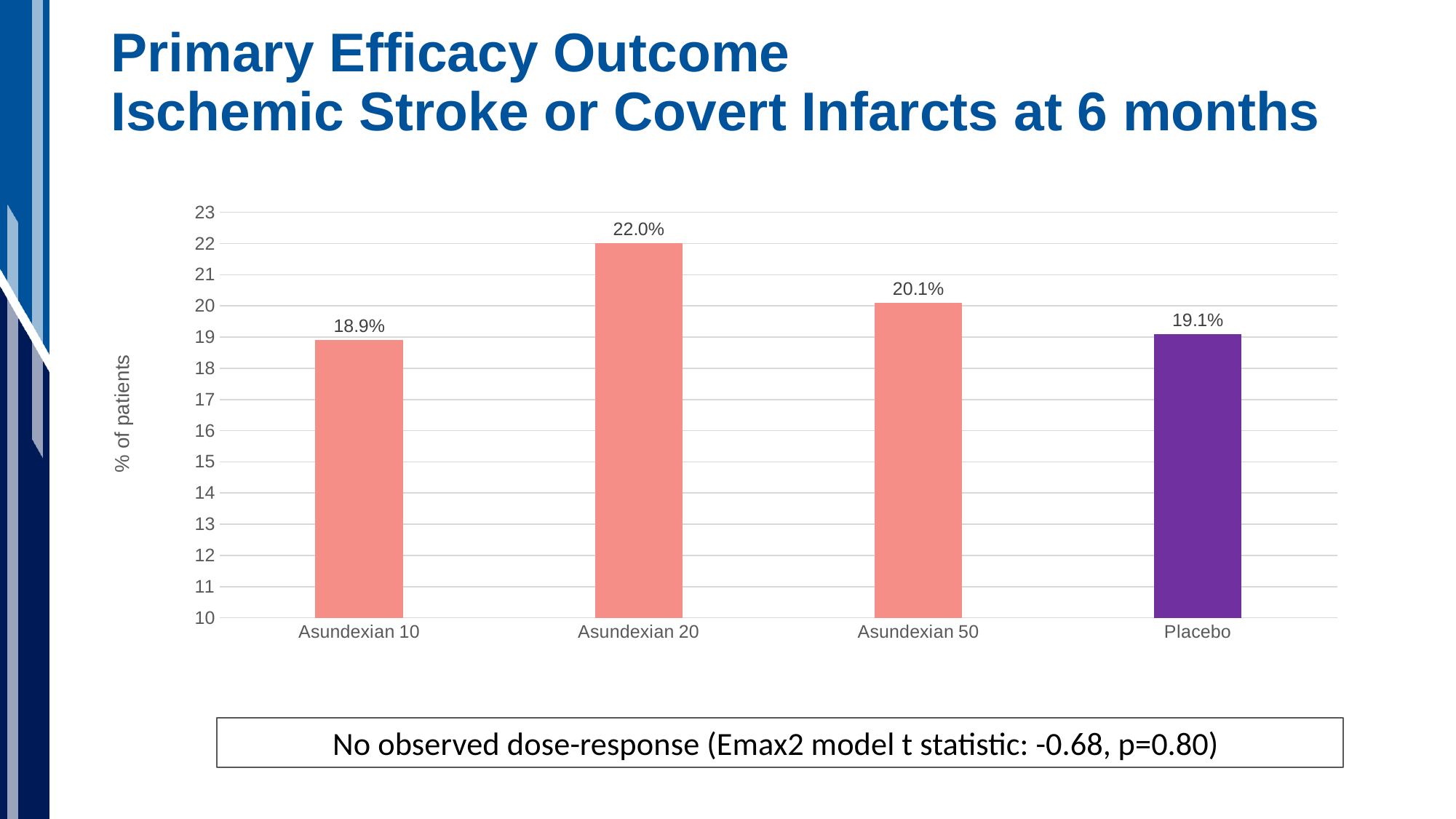
What is the value for Asundexian 20? 22.0% What is the value for Asundexian 10? 18.9% What is the value for Placebo? 19.1% Is the value for Asundexian 20 greater or less than 21? greater What is the label of the y axis? % of patients What is the value for Asundexian 50? 20.1% Which category has the highest value? Asundexian 20 What is the difference between the values for Asundexian 20 and Placebo? 2.9% How many categories are shown on the x axis? 4 Which category has the lowest value? Asundexian 10 Which is larger, the value for Asundexian 50 or the value for Placebo? Asundexian 50 What kind of chart is shown on the slide? bar chart